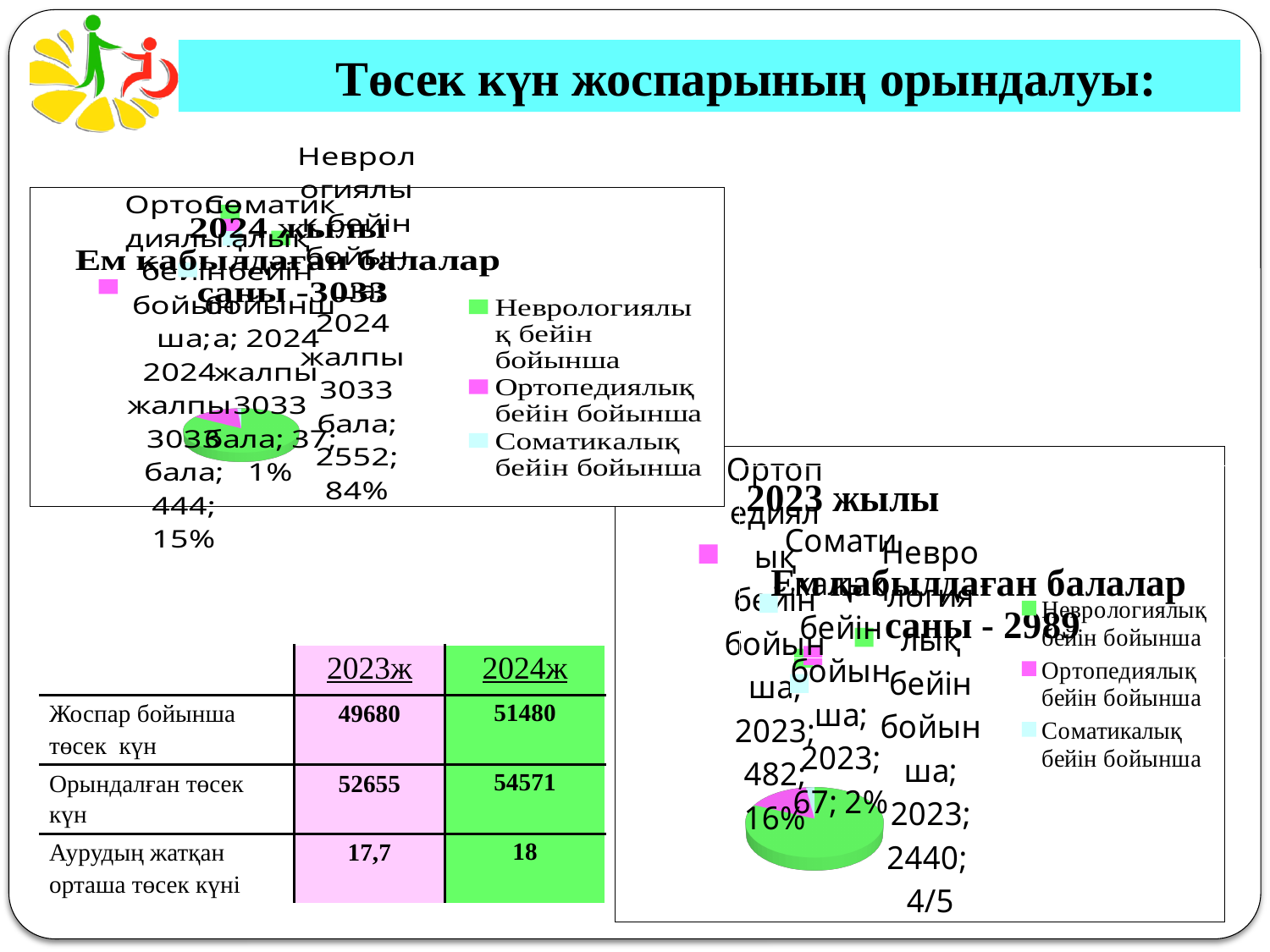
In the 2024 жылы chart, what is the value for Соматикалық бейін бойынша? 37 What total number of children is stated in the title of the 2023 жылы chart? 2989 In the 2024 жылы chart, what share of the pie is Неврологиялық бейін бойынша? 84% How many entries does the legend of the 2024 жылы chart list? 3 How many slices does the 2023 жылы pie chart have? 3 In the 2024 жылы chart, what share of the pie is Ортопедиялық бейін бойынша? 15% In the 2023 жылы chart, what is the value for Неврологиялық бейін бойынша? 2440 What kind of chart is the 2023 жылы chart on the right of the slide? pie chart What kind of chart is the 2024 жылы chart on the left of the slide? pie chart In the 2023 жылы chart, what share of the pie is Ортопедиялық бейін бойынша? 16% In the 2024 жылы chart, what is the value for Неврологиялық бейін бойынша? 2552 In the 2024 жылы chart, which category has the largest slice? Неврологиялық бейін бойынша